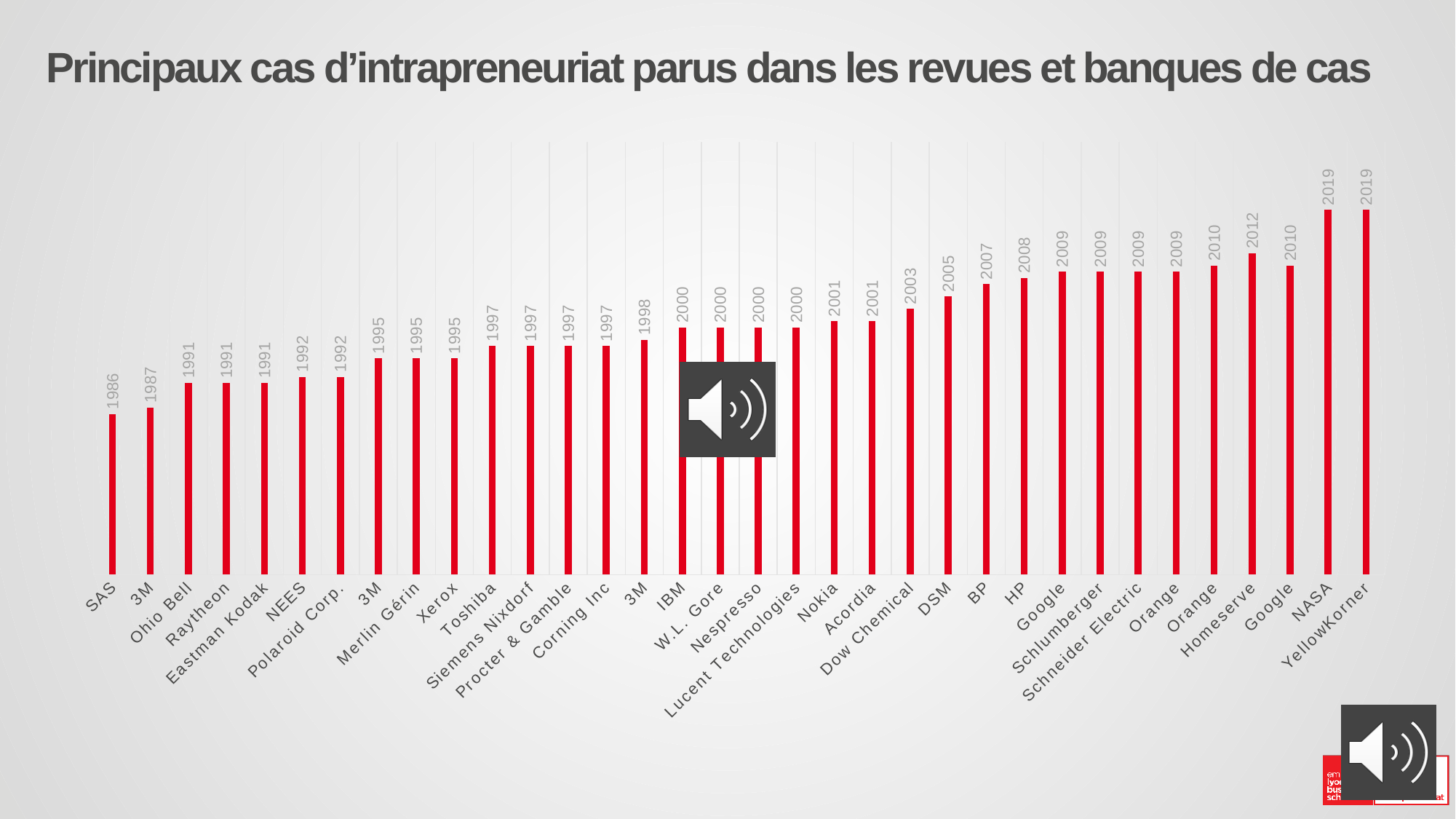
How many bars are plotted on the chart? 34 What is the difference in years between BP and Nokia? 6 What kind of chart is shown on the slide? bar chart Which has the later year, Toshiba or DSM? DSM Which company has the lowest (earliest) year on the chart? SAS What year is shown for Nespresso? 2000 What year is shown for Dow Chemical? 2003 What year is shown for Schlumberger? 2009 What year is shown for Homeserve? 2012 What year is shown for SAS? 1986 What is the difference in years between YellowKorner and SAS? 33 Do the values generally rise or fall from left to right along the x axis? rise